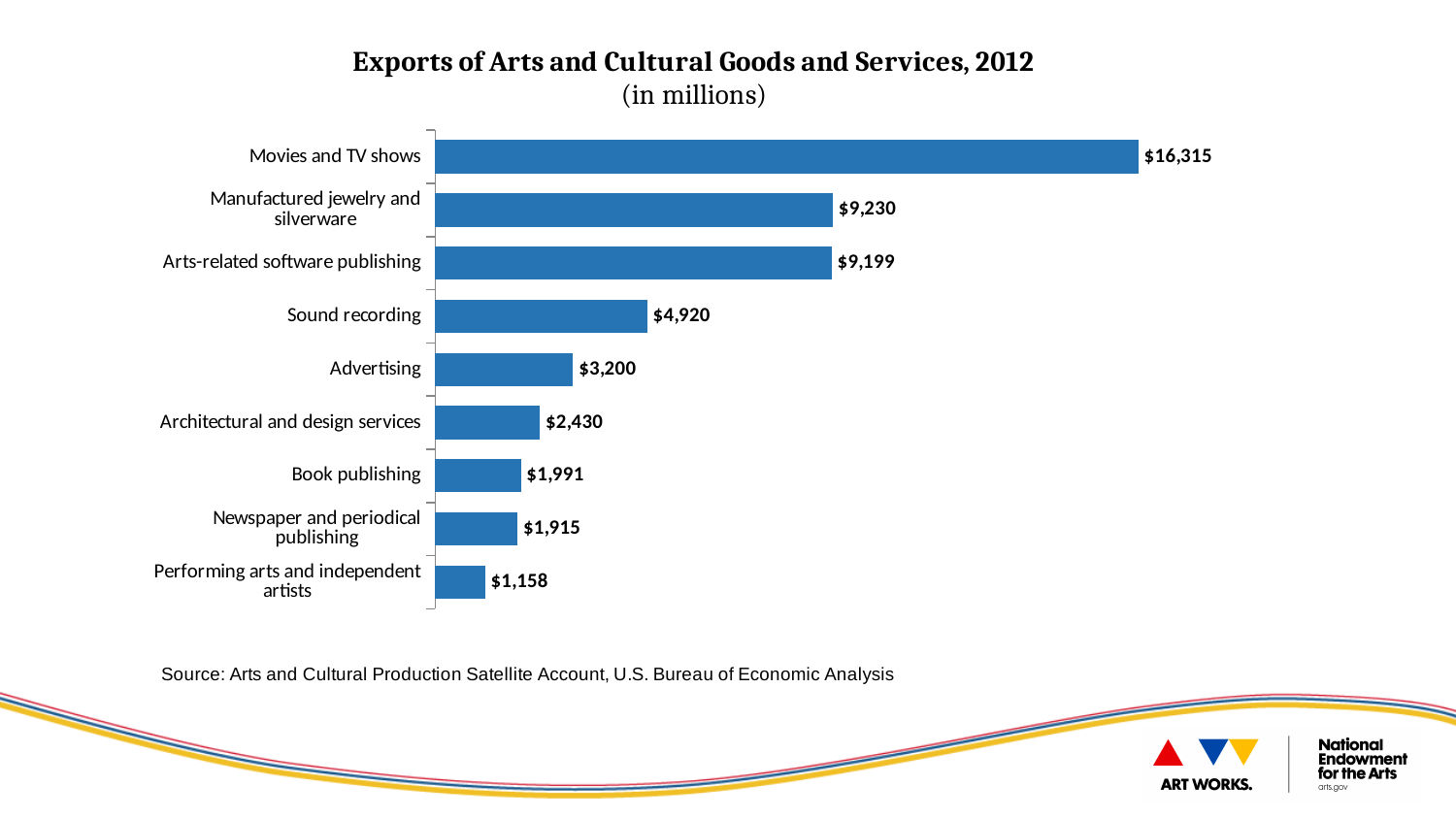
Which is larger, the export value for Sound recording or for Advertising? Sound recording How many categories are shown in the chart? 9 What is the title of the chart? Exports of Arts and Cultural Goods and Services, 2012 What is the difference between the export values for Advertising and Book publishing? $1,209 What kind of chart is shown on the slide? Bar chart What is the export value for Architectural and design services? $2,430 What is the difference between the export values for Movies and TV shows and Manufactured jewelry and silverware? $7,085 Which is larger, the export value for Book publishing or for Performing arts and independent artists? Book publishing What is the export value for Sound recording? $4,920 Which category has the lowest export value? Performing arts and independent artists Which category has the highest export value? Movies and TV shows What is the export value for Movies and TV shows? $16,315